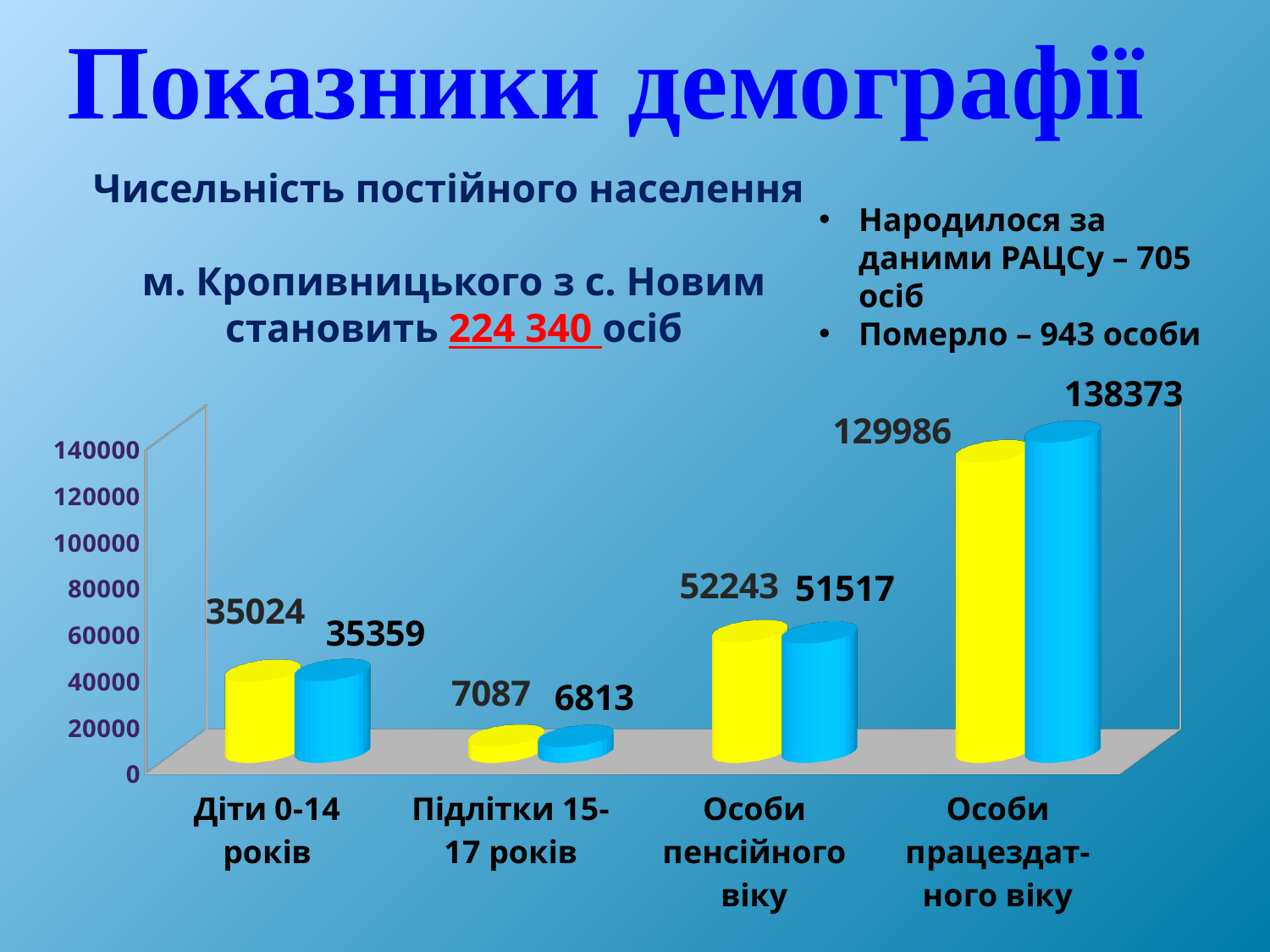
What is the value of the blue bar for Особи пенсійного віку? 51517 How many categories are shown on the x axis of the chart? 4 What is the value of the yellow bar for Підлітки 15-17 років? 7087 Which category has the lowest values in the chart? Підлітки 15-17 років Which category has the highest values in the chart? Особи працездатного віку What type of chart is shown on the slide? bar chart What is the value of the yellow bar for Діти 0-14 років? 35024 Which is larger for Особи пенсійного віку: the yellow bar or the blue bar? the yellow bar What is the highest tick value shown on the vertical axis of the chart? 140000 What is the value of the blue bar for Особи працездатного віку? 138373 What is the difference between the blue and yellow bars for Особи працездатного віку? 8387 What is the difference between the yellow and blue bars for Підлітки 15-17 років? 274